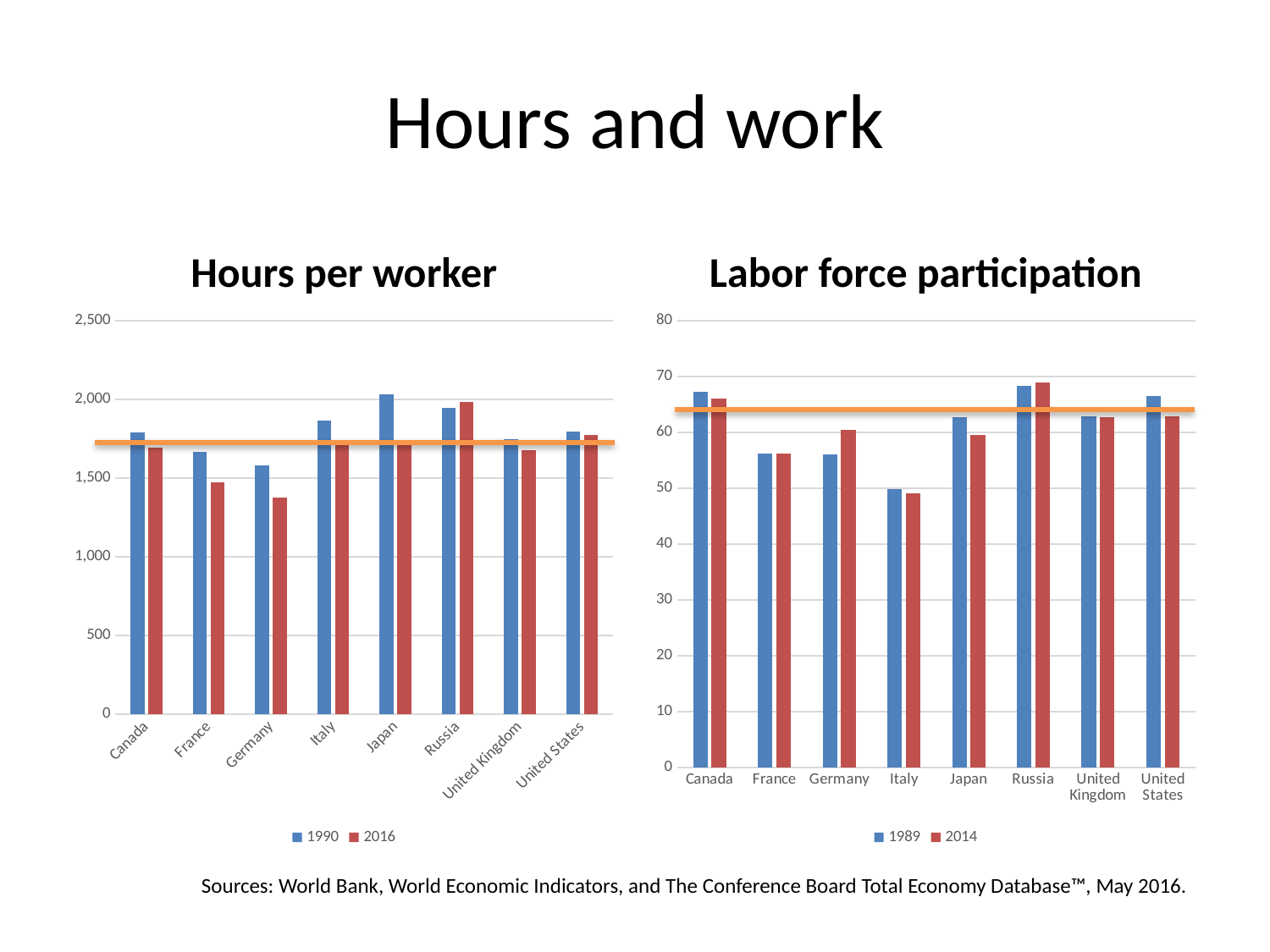
In the Hours per worker chart, how many countries are shown on the x axis? 8 In the Hours per worker chart, which country has the lowest value for 2016? Germany In the Labor force participation chart, which country has the highest value for 2014? Russia In the Hours per worker chart, is the 1990 value for Japan greater or less than 2,000? greater In the Hours per worker chart, which country has the highest value for 1990? Japan In the Labor force participation chart, which is larger for Germany: the 1989 value or the 2014 value? 2014 How many series does the legend of the Labor force participation chart list? 2 In the Labor force participation chart, is the 1989 value for Canada greater or less than 60? greater In the Labor force participation chart, which country has the lowest value for 1989? Italy What kind of chart is the Hours per worker chart? Bar chart In the Hours per worker chart, which is larger for France: the 1990 value or the 2016 value? 1990 In the Hours per worker chart, is the 2016 value for Germany greater or less than 1,500? less